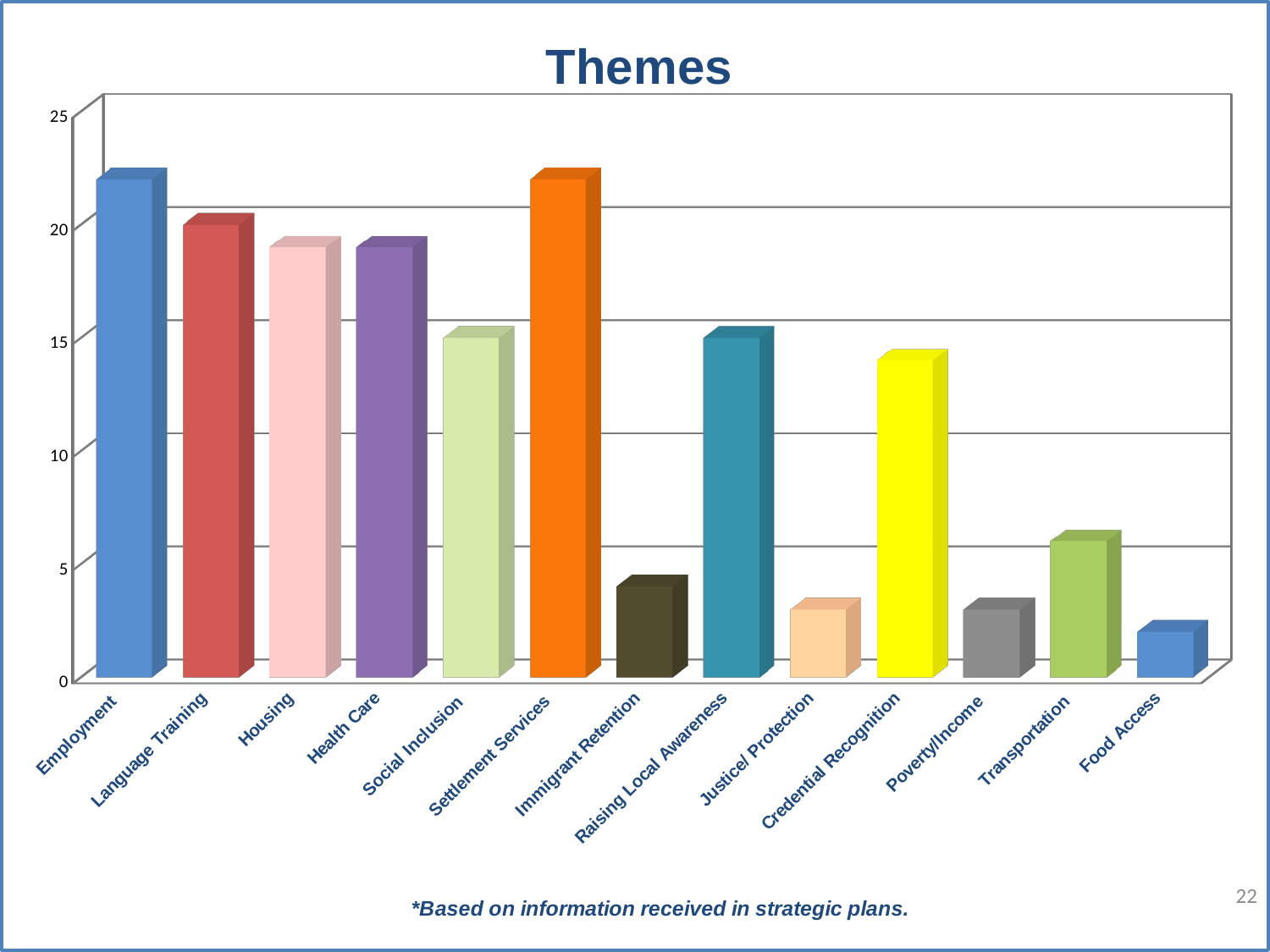
Is the value for Immigrant Retention greater or less than 5? less Which is larger, the value for Housing or the value for Social Inclusion? Housing What kind of chart is shown on the slide? bar chart Is the value for Settlement Services greater or less than 20? greater Is the value for Transportation greater or less than 5? greater How many categories are plotted on the x axis? 13 What footnote appears below the chart? *Based on information received in strategic plans. Which is larger, the value for Employment or the value for Immigrant Retention? Employment What is the title of the chart? Themes